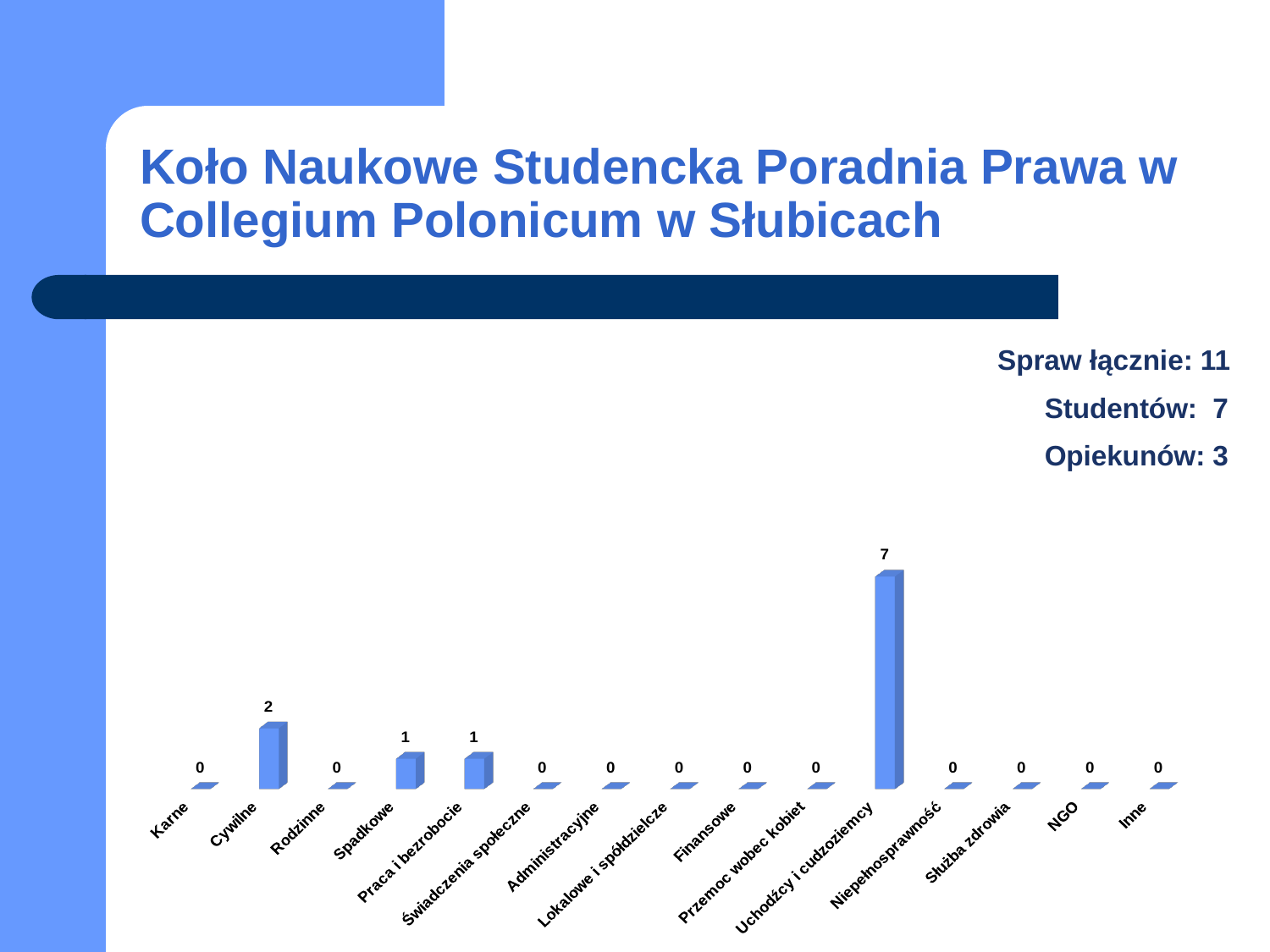
Which category has the highest value? Uchodźcy i cudzoziemcy Which is larger, the value for Cywilne or the value for Spadkowe? Cywilne What is the value for Karne? 0 What is the difference between the values for Uchodźcy i cudzoziemcy and Cywilne? 5 What kind of chart is shown on the slide? bar chart What is the value for Spadkowe? 1 How many categories are shown on the x axis of the chart? 15 What is the value for Uchodźcy i cudzoziemcy? 7 What is the difference between the values for Cywilne and Praca i bezrobocie? 1 What is the value for Cywilne? 2 Which is larger, the value for Uchodźcy i cudzoziemcy or the value for Praca i bezrobocie? Uchodźcy i cudzoziemcy How many categories have a value of 0? 11